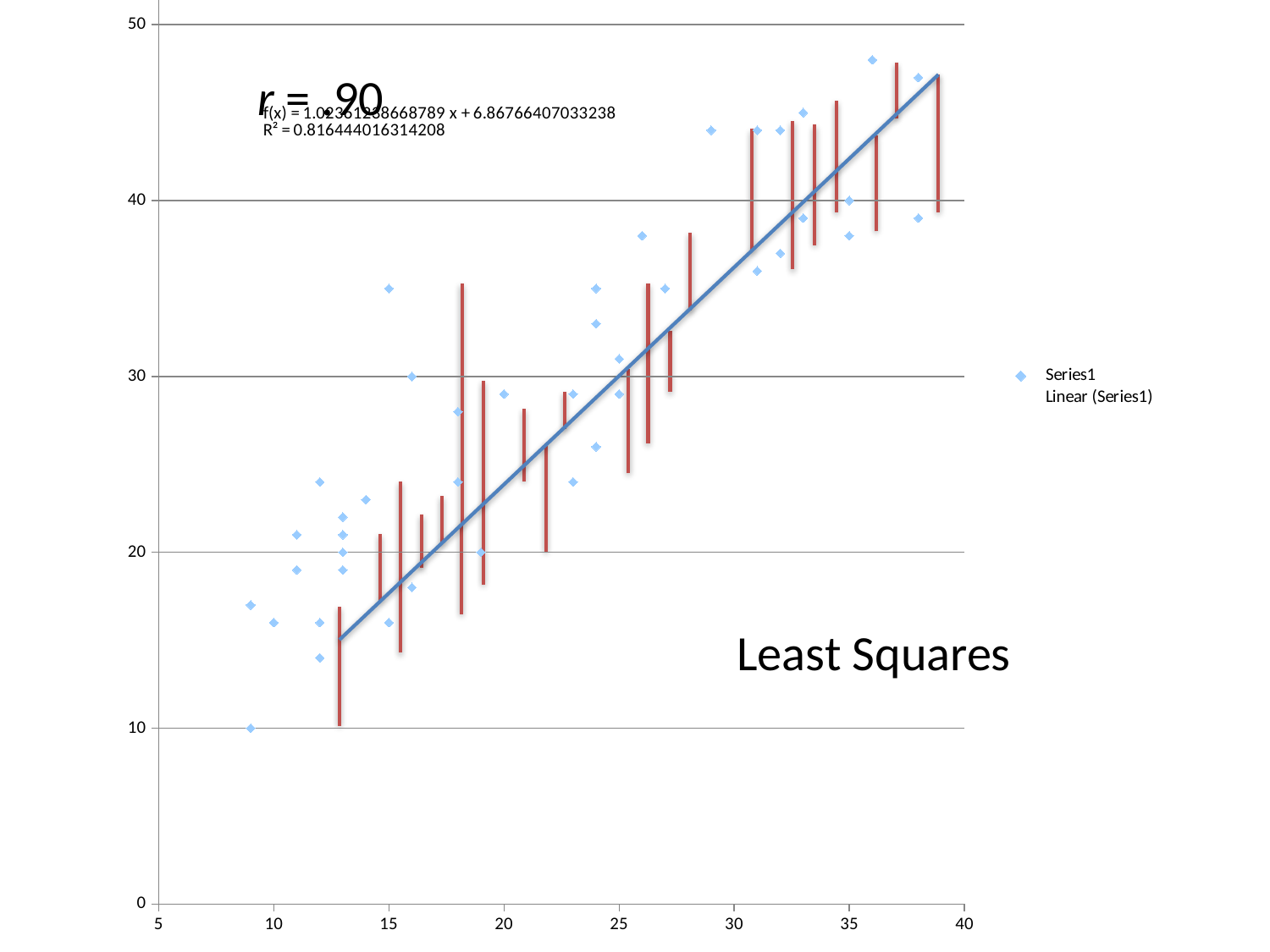
Which is larger: the plotted point near x = 36 at the top of the chart or the plotted point near x = 9 at the bottom of the chart? The point near x = 36 What is the highest value shown on the y axis? 50 What are the two entries listed in the legend? Series1 and Linear (Series1) What kind of chart is shown on the slide? Scatter chart Is the highest plotted point on the chart greater or less than 40? greater Is the plotted point at x = 29 greater or less than 40? greater Is the plotted point at x = 15 that lies above the trendline greater or less than 30? greater What R² value is printed on the chart? 0.816444016314208 How many entries does the legend list? 2 Do the plotted values generally rise or fall as x increases? Rise